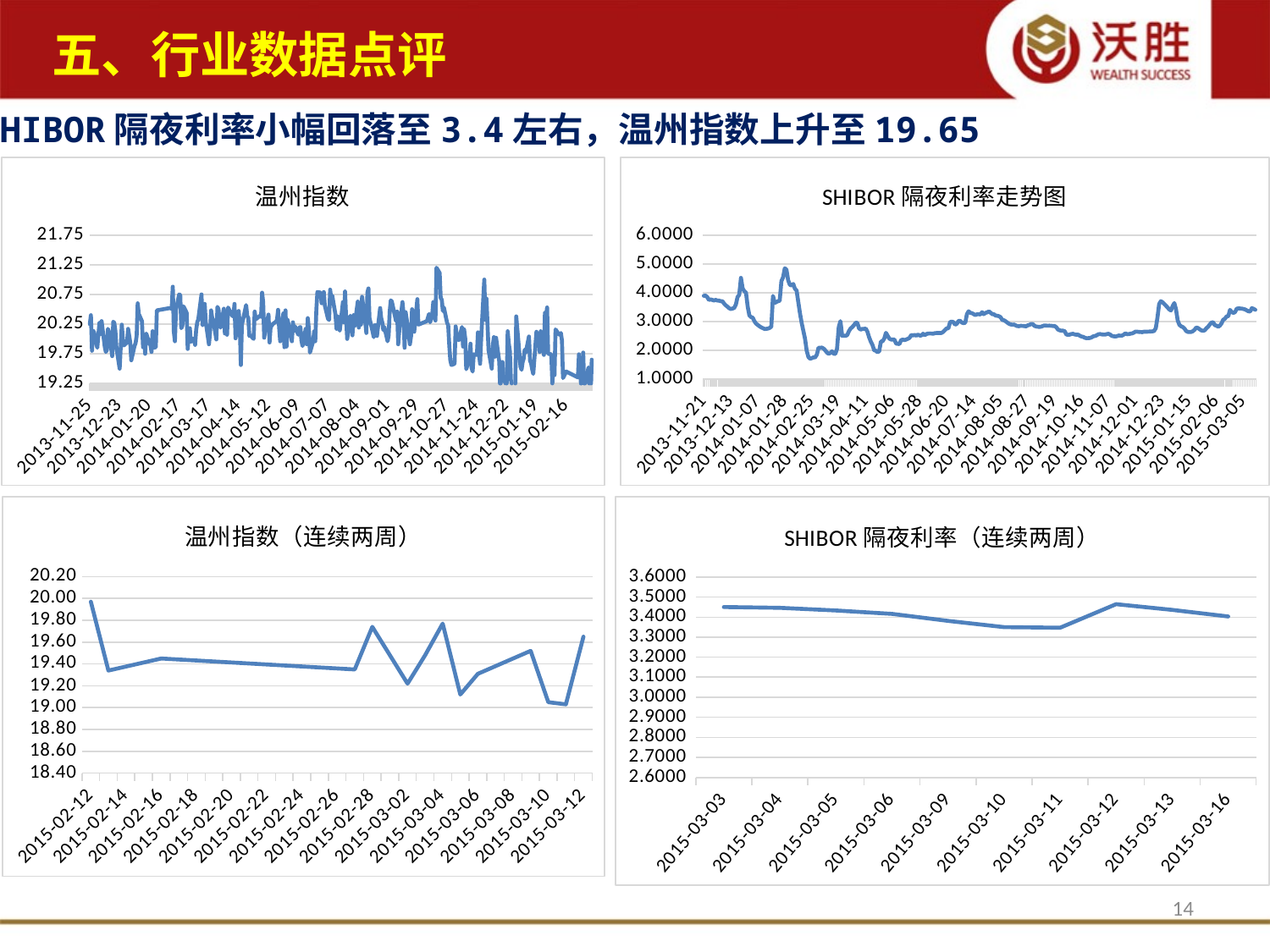
What kind of chart is the '温州指数（连续两周）' chart at the bottom left of the slide? line chart In the 'SHIBOR 隔夜利率（连续两周）' chart, how many dates are labelled on the x axis? 10 In the 'SHIBOR 隔夜利率（连续两周）' chart, is the value for 2015-03-10 greater or less than 3.4000? less In the '温州指数（连续两周）' chart, is the value for 2015-03-10 greater or less than 19.20? less What is the title of the chart at the top left of the slide? 温州指数 How many charts are shown on the slide? 4 What kind of chart is the 'SHIBOR 隔夜利率走势图' chart at the top right of the slide? line chart In the 'SHIBOR 隔夜利率（连续两周）' chart, is the value for 2015-03-03 greater or less than 3.4000? greater In the 'SHIBOR 隔夜利率（连续两周）' chart, which is larger, the value for 2015-03-12 or the value for 2015-03-10? 2015-03-12 In the '温州指数（连续两周）' chart, on which date is the value highest? 2015-02-12